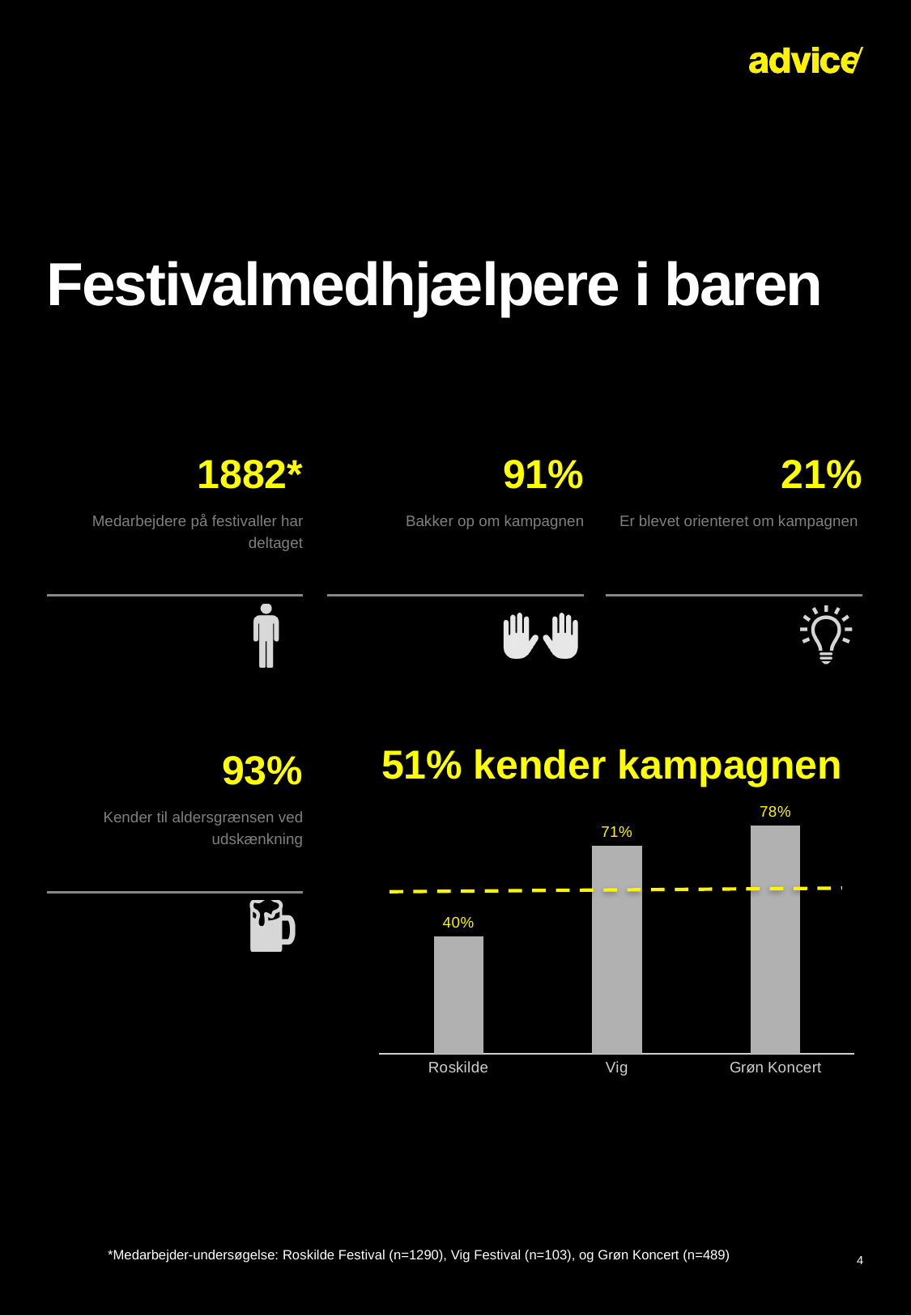
What is the difference between the values for Vig and Roskilde? 31% Which category has the highest value in the chart? Grøn Koncert Which is larger, the value for Vig or the value for Roskilde? Vig What kind of chart is shown on the slide? Bar chart What is the value for Roskilde in the chart? 40% What is the difference between the values for Grøn Koncert and Roskilde? 38% What is the title of the chart? 51% kender kampagnen Do the values rise or fall from Roskilde to Grøn Koncert along the x axis? Rise Which category has the lowest value in the chart? Roskilde How many categories are shown in the chart? 3 What is the value for Grøn Koncert in the chart? 78% What is the value for Vig in the chart? 71%